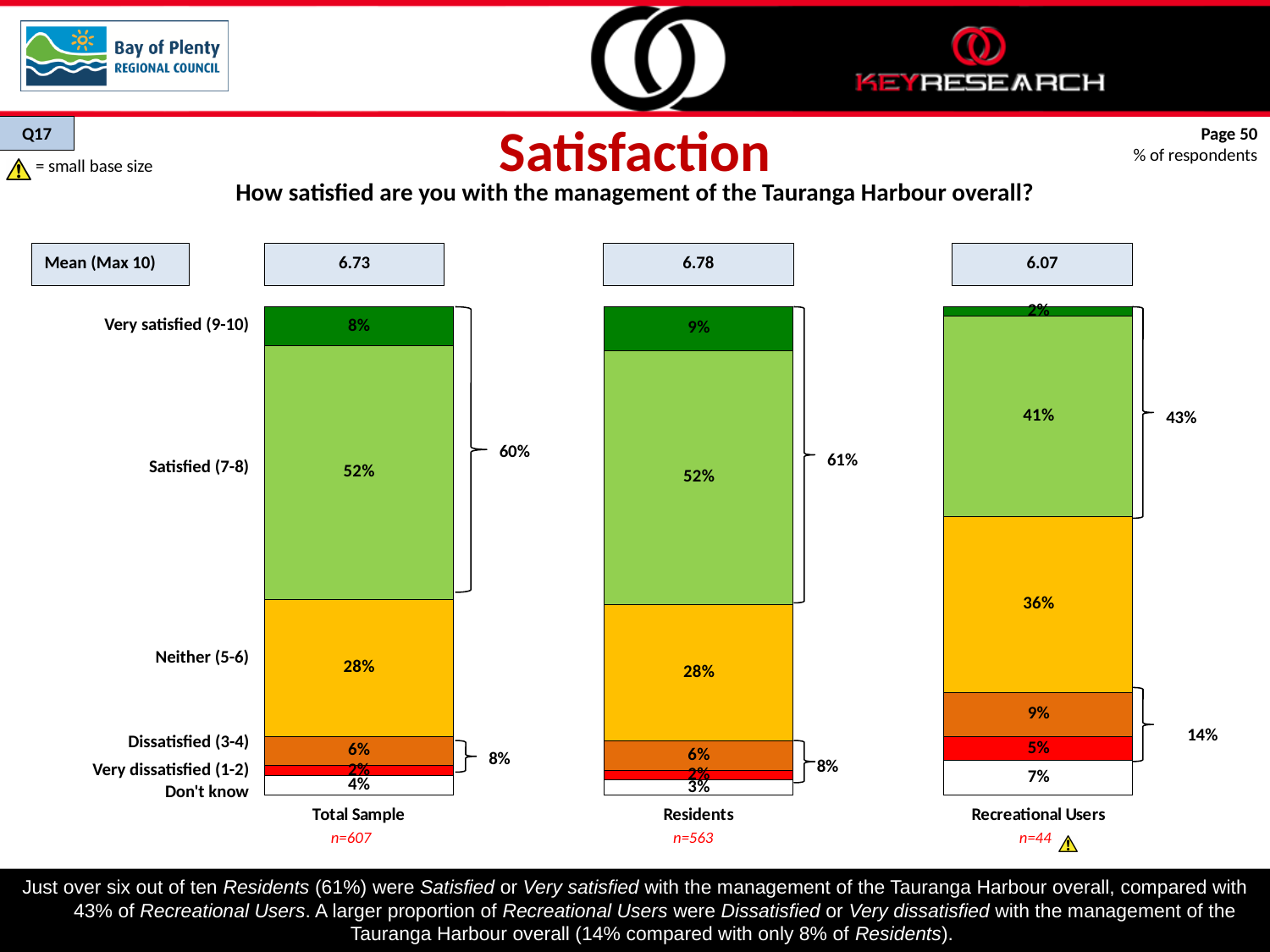
How many groups (bars) are shown in the chart? 3 What is the sample size (n) for Recreational Users? n=44 What percentage of the Total Sample were Satisfied (7-8) with the management of the Tauranga Harbour overall? 52% What percentage of Recreational Users were Neither (5-6) satisfied nor dissatisfied? 36% What is the mean satisfaction score (Max 10) for Recreational Users? 6.07 Which response category has the smallest share among Recreational Users? Very satisfied (9-10) Which group has a larger combined Dissatisfied or Very dissatisfied share, Residents or Recreational Users? Recreational Users Which group has the highest mean satisfaction score? Residents What is the combined share of Satisfied and Very satisfied respondents for Residents? 61% What percentage of Residents answered Don't know? 3% What is the difference between the Satisfied (7-8) share for Residents and for Recreational Users? 11 percentage points What type of chart is used on this slide? Stacked bar chart